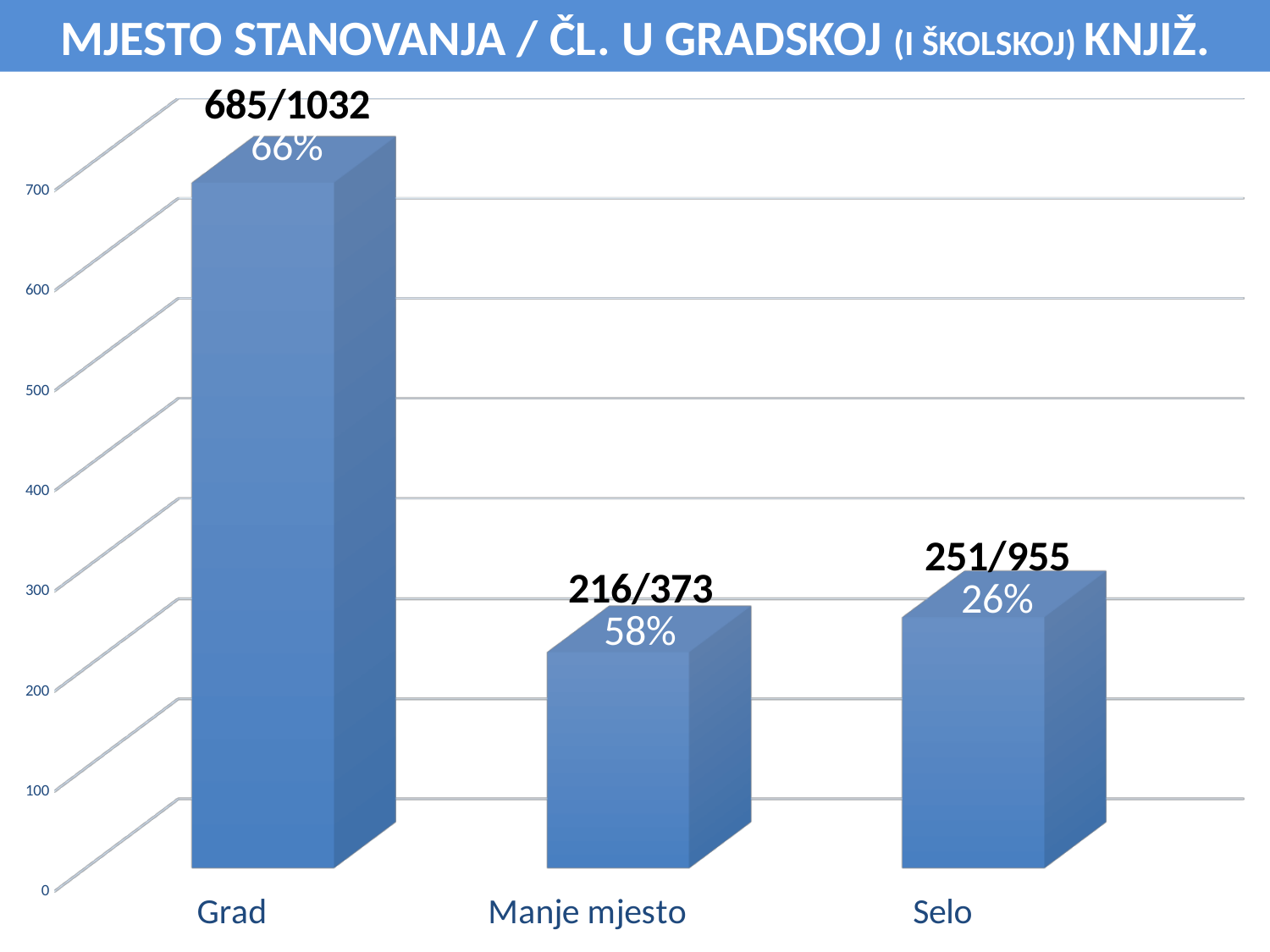
What percentage is printed on the bar for Selo? 26% What percentage is printed on the bar for Manje mjesto? 58% How many categories are shown on the x axis? 3 What type of chart is shown on the slide? bar chart What is the title of the slide? MJESTO STANOVANJA / ČL. U GRADSKOJ (I ŠKOLSKOJ) KNJIŽ. Which category has the tallest bar? Grad What is the data label shown above the bar for Selo? 251/955 What is the data label shown above the bar for Grad? 685/1032 Which bar is taller, Selo or Manje mjesto? Selo Which category has the shortest bar? Manje mjesto Is the bar for Grad greater or less than 600 on the vertical axis? greater What is the difference between the first number for Grad (685) and the first number for Selo (251)? 434